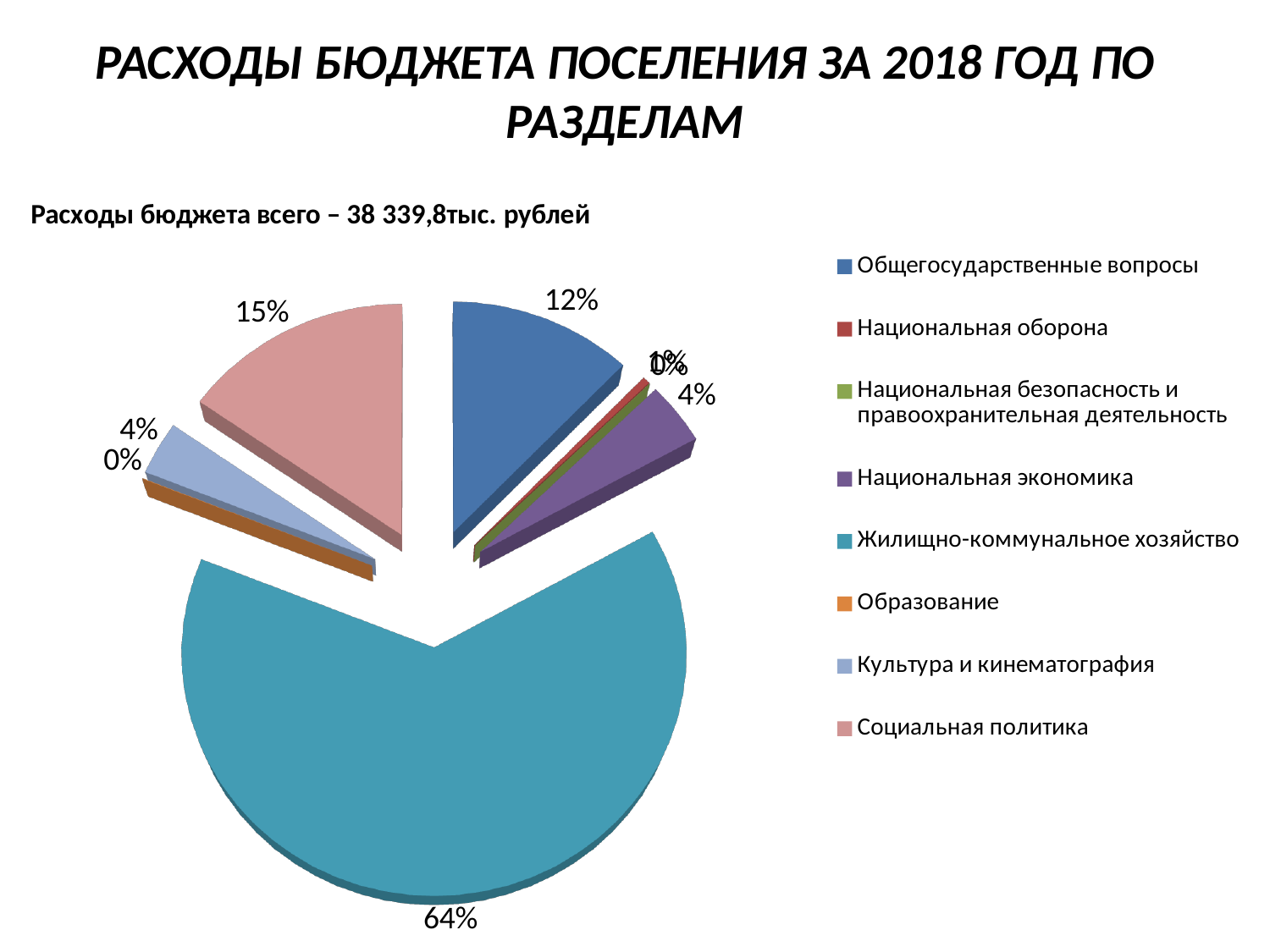
Which is larger, the share for Социальная политика or the share for Общегосударственные вопросы? Социальная политика What is the title of the slide containing the chart? РАСХОДЫ БЮДЖЕТА ПОСЕЛЕНИЯ ЗА 2018 ГОД ПО РАЗДЕЛАМ What share of the pie does Жилищно-коммунальное хозяйство have? 64% Which category has the largest share of the pie? Жилищно-коммунальное хозяйство What is the value shown for Национальная экономика? 4% What is the difference between the share for Жилищно-коммунальное хозяйство and the share for Социальная политика? 49 percentage points How many categories does the legend list? 8 What is the value shown for Общегосударственные вопросы? 12% What is the value shown for Культура и кинематография? 4% What is the value shown for Образование? 0% What share of the pie does Социальная политика have? 15% What kind of chart is shown on the slide? pie chart